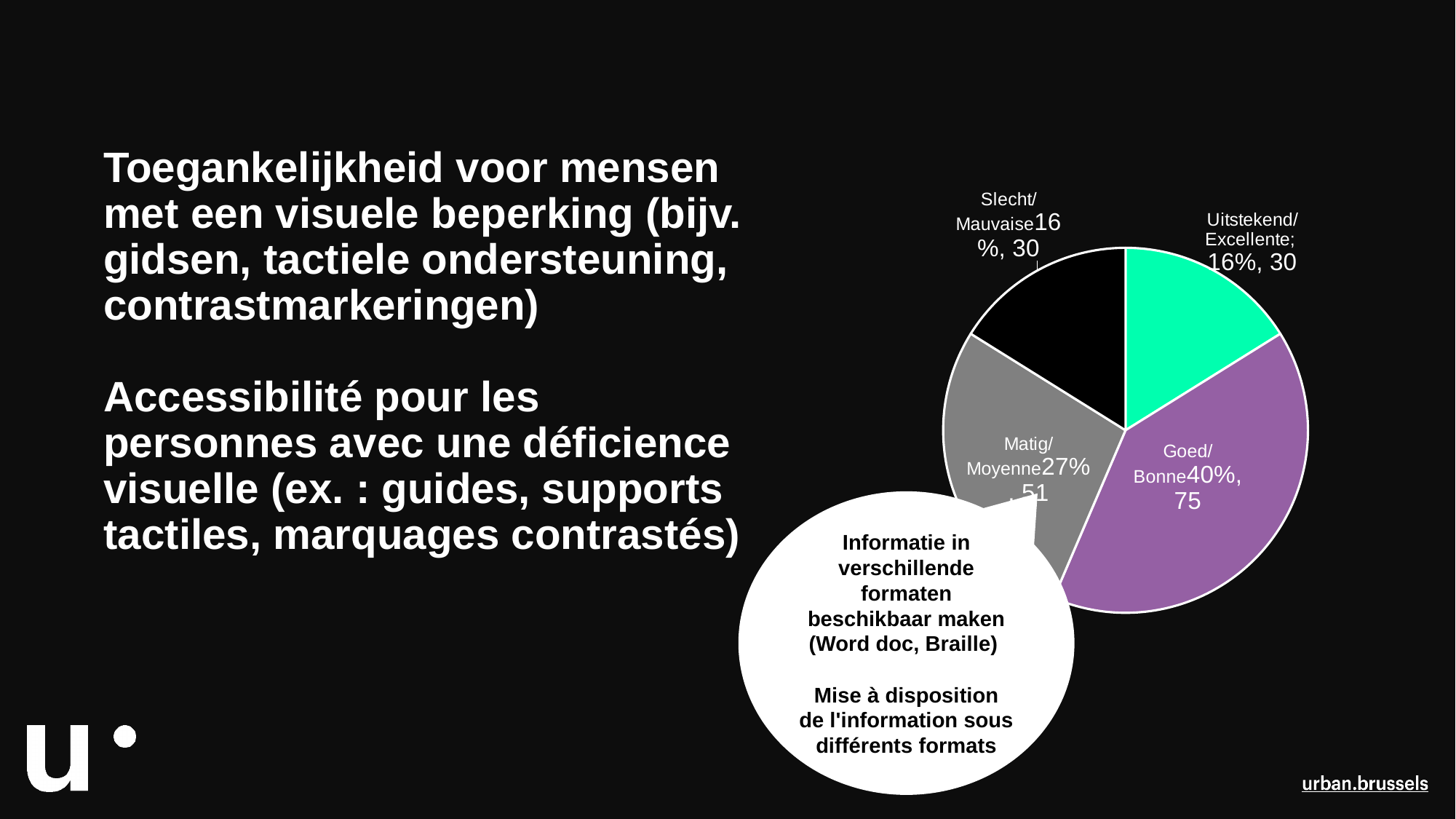
What percentage is shown for the Matig/Moyenne slice? 27% What percentage is shown for the Uitstekend/Excellente slice? 16% What kind of chart is shown on the slide? pie chart What is the count shown for the Slecht/Mauvaise slice? 30 What is the combined count of the Slecht/Mauvaise and Uitstekend/Excellente slices? 60 What is the count shown for the Goed/Bonne slice? 75 Which is larger, the Matig/Moyenne slice or the Slecht/Mauvaise slice? Matig/Moyenne How many slices does the pie chart have? 4 What share of the pie does the Goed/Bonne slice represent? 40% What colour is the Goed/Bonne slice in the pie chart? purple Which slice of the pie chart is the largest? Goed/Bonne What is the difference in count between the Goed/Bonne slice and the Matig/Moyenne slice? 24